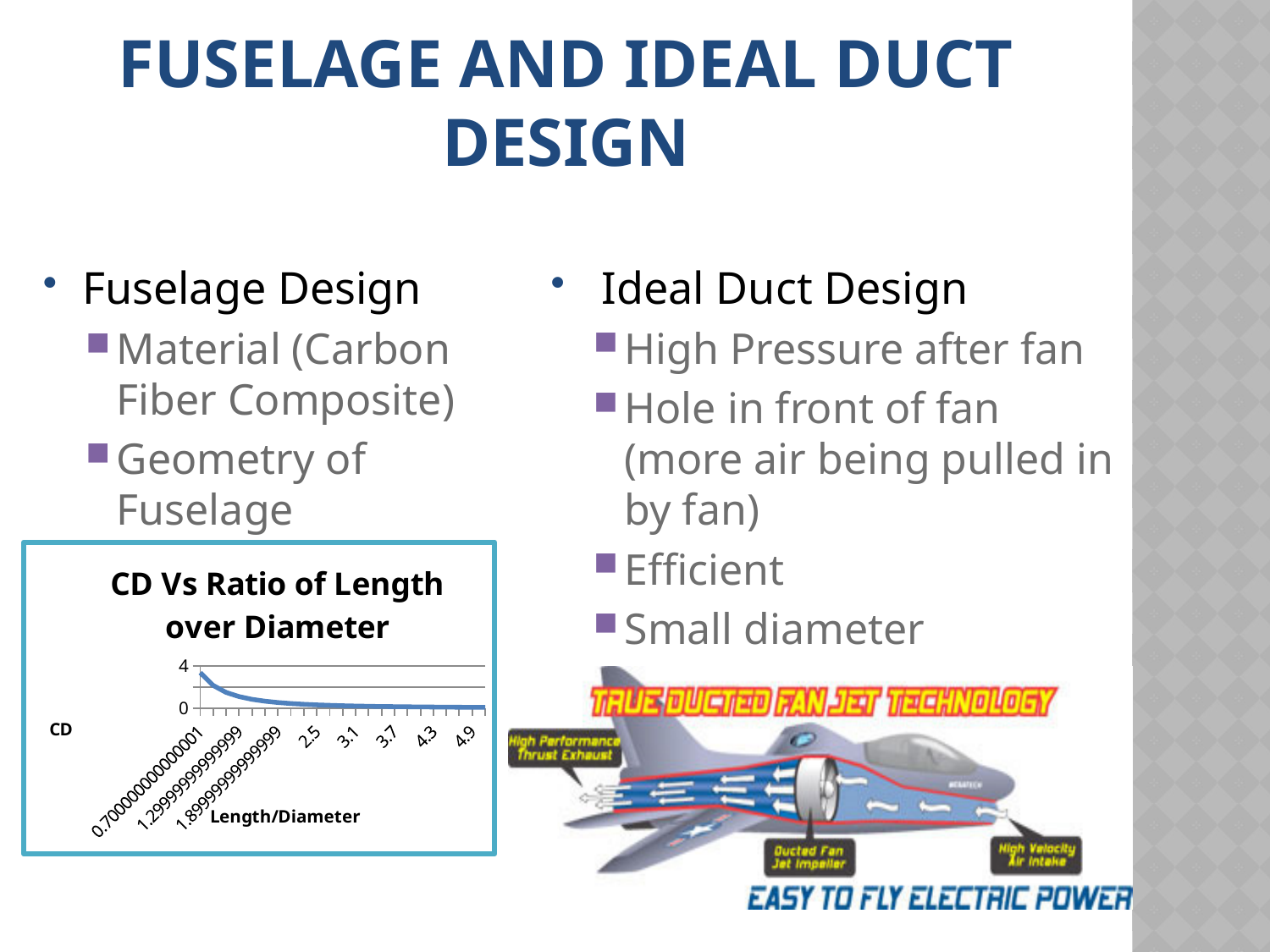
How many Length/Diameter labels are shown on the x axis of the chart "CD Vs Ratio of Length over Diameter"? 8 In the chart "CD Vs Ratio of Length over Diameter", is the CD value at Length/Diameter 4.9 greater or less than 4? less In the chart "CD Vs Ratio of Length over Diameter", which has the larger CD value: Length/Diameter 0.700000000000001 or 4.9? 0.700000000000001 In the chart "CD Vs Ratio of Length over Diameter", is the CD value at Length/Diameter 0.700000000000001 greater or less than 0? greater In the chart "CD Vs Ratio of Length over Diameter", at which labelled Length/Diameter value is CD highest? 0.700000000000001 What is the x-axis title of the chart "CD Vs Ratio of Length over Diameter"? Length/Diameter What is the title of the chart on the slide? CD Vs Ratio of Length over Diameter In the chart "CD Vs Ratio of Length over Diameter", does CD rise or fall as Length/Diameter increases? fall In the chart "CD Vs Ratio of Length over Diameter", is the CD value at Length/Diameter 2.5 greater or less than 4? less What kind of chart is "CD Vs Ratio of Length over Diameter"? line chart